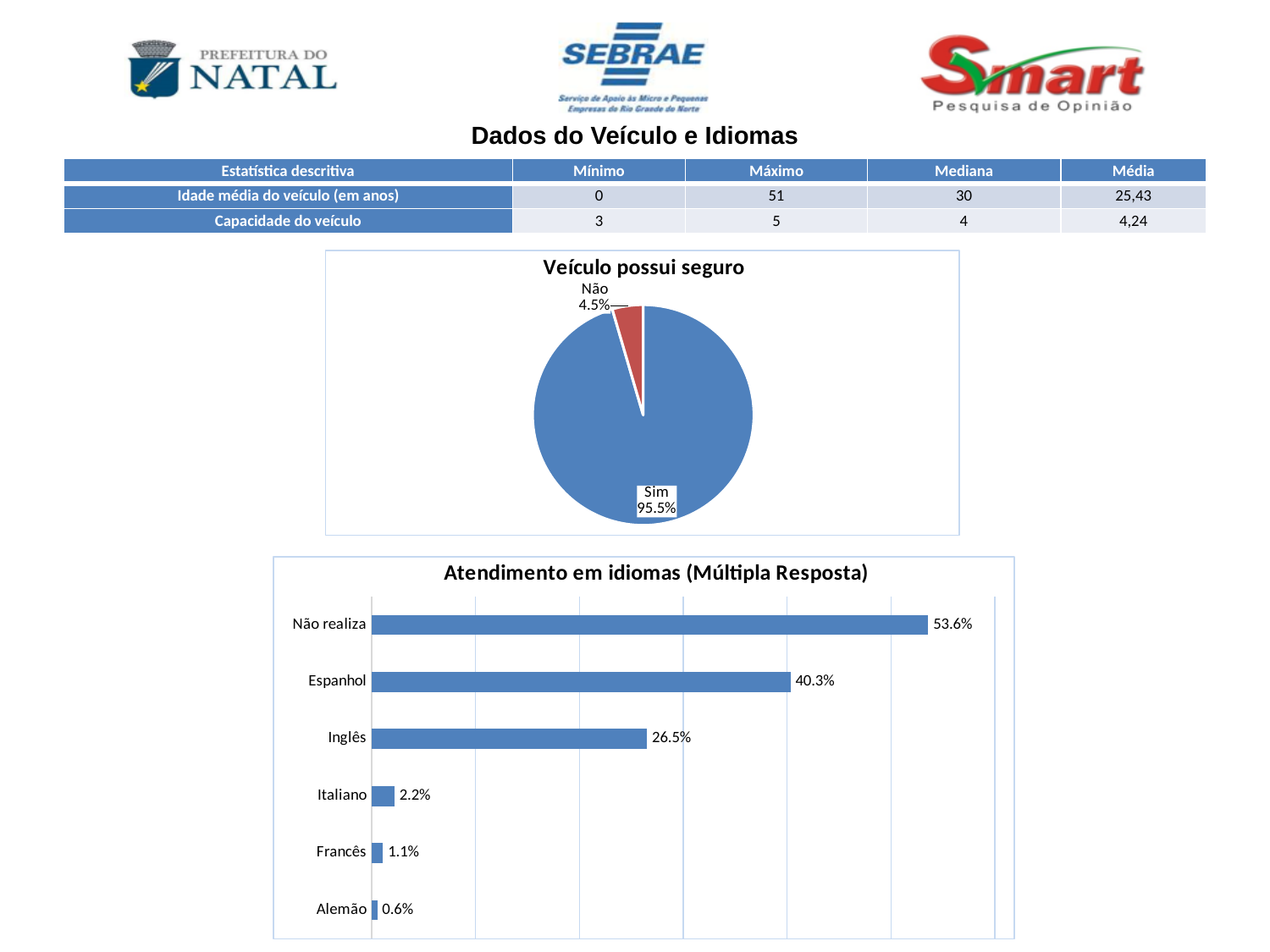
In the 'Atendimento em idiomas (Múltipla Resposta)' chart, which is larger, Italiano or Francês? Italiano In the 'Atendimento em idiomas (Múltipla Resposta)' chart, what is the value for Espanhol? 40.3% In the 'Atendimento em idiomas (Múltipla Resposta)' chart, which category has the highest value? Não realiza How many slices does the 'Veículo possui seguro' pie chart have? 2 What kind of chart is 'Veículo possui seguro'? pie chart In the 'Veículo possui seguro' chart, what share of vehicles have insurance (Sim)? 95.5% In the 'Atendimento em idiomas (Múltipla Resposta)' chart, which category has the lowest value? Alemão In the 'Atendimento em idiomas (Múltipla Resposta)' chart, what is the value for Inglês? 26.5% How many categories are shown in the 'Atendimento em idiomas (Múltipla Resposta)' chart? 6 In the 'Veículo possui seguro' chart, what is the value for 'Não'? 4.5% In the 'Atendimento em idiomas (Múltipla Resposta)' chart, what is the difference between Espanhol and Inglês? 13.8% What kind of chart is 'Atendimento em idiomas (Múltipla Resposta)'? bar chart